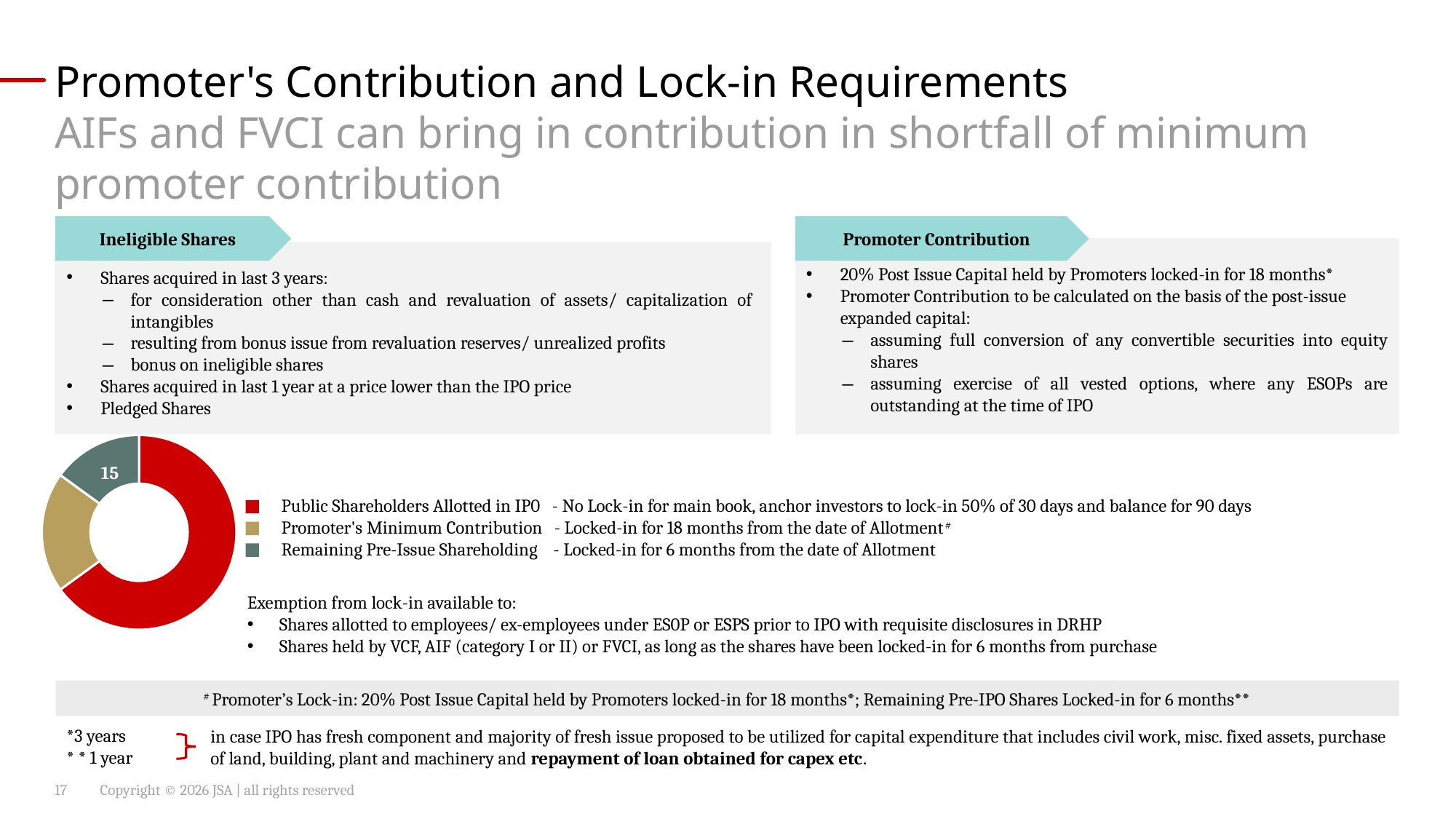
What kind of chart is shown on the slide? Pie chart (donut) Which category takes up the largest slice of the donut chart? Public Shareholders Allotted in IPO Which legend entry of the donut chart is shown in a tan/gold colour? Promoter's Minimum Contribution What colour is the Public Shareholders Allotted in IPO slice in the donut chart? Red Which slice is larger in the donut chart: Public Shareholders Allotted in IPO or Promoter's Minimum Contribution? Public Shareholders Allotted in IPO How many slices does the donut chart have? 3 Which category takes up the smallest slice of the donut chart? Remaining Pre-Issue Shareholding Which slice is larger in the donut chart: Promoter's Minimum Contribution or Remaining Pre-Issue Shareholding? Promoter's Minimum Contribution What value is labelled on the Remaining Pre-Issue Shareholding slice of the donut chart? 15 How many entries does the legend of the donut chart list? 3